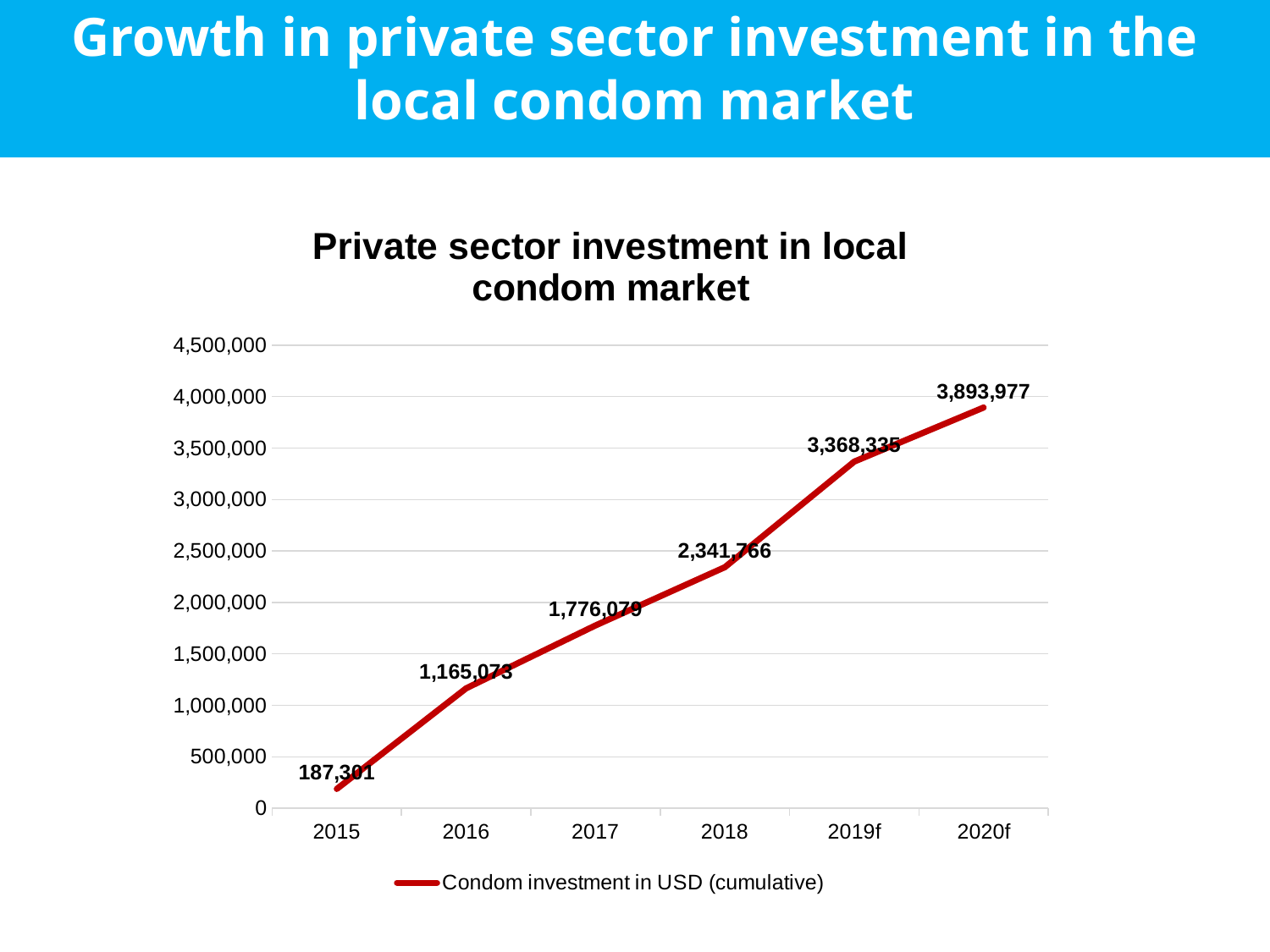
Which year has the lowest value? 2015 How many years are shown on the x axis? 6 What kind of chart is this? line chart How many series does the legend list? 1 Is the value for 2019f greater or less than 3,000,000? greater Is the value for 2018 greater or less than 2,000,000? greater Do the values rise or fall from 2015 to 2020f? rise What is the value for 2020f? 3,893,977 Which year has the highest value? 2020f Is the value for 2015 greater or less than 500,000? less Which is larger, the value for 2017 or the value for 2019f? 2019f